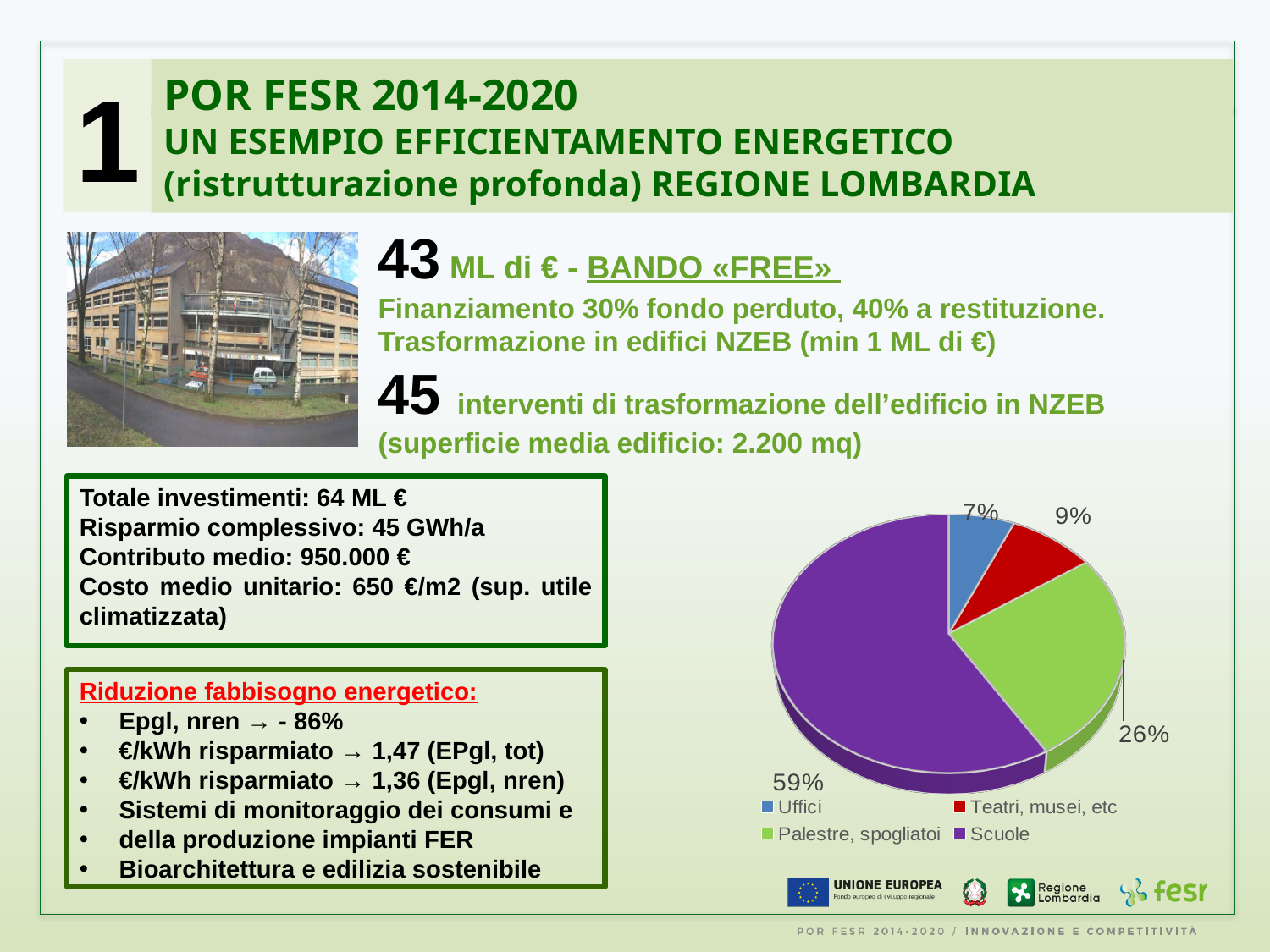
Which category is shown in green in the pie chart legend? Palestre, spogliatoi What colour is the Scuole slice in the pie chart? purple Which category has the largest slice in the pie chart? Scuole Which category has the smallest slice in the pie chart? Uffici What share of the pie chart does Teatri, musei, etc represent? 9% Which slice is larger in the pie chart, Teatri, musei, etc or Uffici? Teatri, musei, etc What share of the pie chart does Scuole represent? 59% How many categories does the pie chart show? 4 What share of the pie chart does Palestre, spogliatoi represent? 26% What kind of chart is shown on the slide? pie chart What share of the pie chart does Uffici represent? 7% What is the difference in percentage points between the Scuole slice and the Palestre, spogliatoi slice? 33